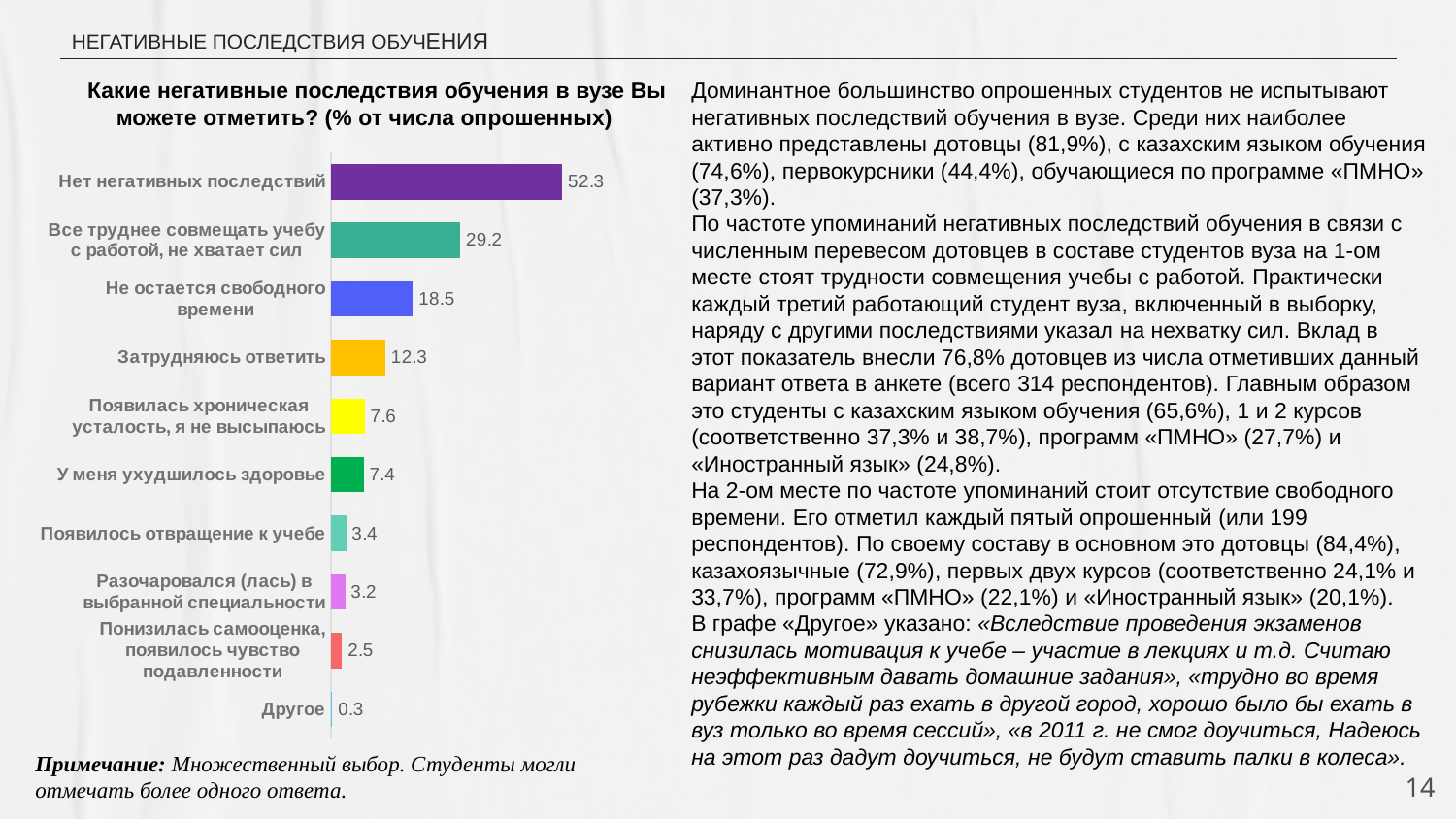
What is the difference between the values for «Нет негативных последствий» and «Все труднее совмещать учебу с работой, не хватает сил»? 23.1 What type of chart is shown on the slide? Bar chart What is the value for «Затрудняюсь ответить»? 12.3 What is the value for «Все труднее совмещать учебу с работой, не хватает сил»? 29.2 Which category has the lowest value? Другое What is the value for «Не остается свободного времени»? 18.5 Which category has the highest value? Нет негативных последствий How many categories are shown in the chart? 10 What is the title of the chart? Какие негативные последствия обучения в вузе Вы можете отметить? (% от числа опрошенных) What is the value for «Нет негативных последствий»? 52.3 What is the value for «Другое»? 0.3 Which is larger: the value for «Не остается свободного времени» or for «Затрудняюсь ответить»? Не остается свободного времени